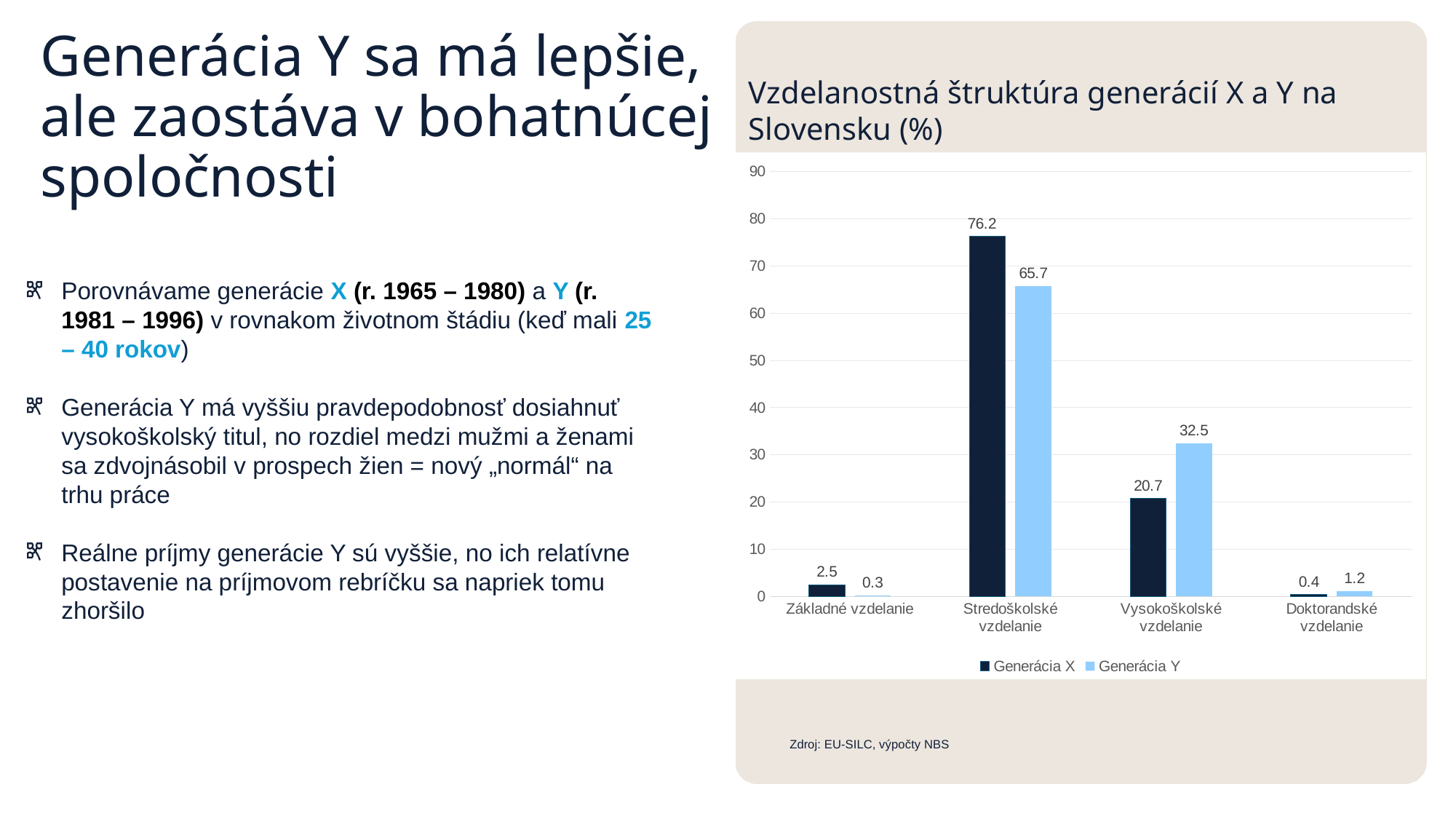
How many categories are shown on the x axis? 4 Which category has the lowest value for Generácia X? Doktorandské vzdelanie How many series does the legend list? 2 What is the value for Generácia X in the Stredoškolské vzdelanie category? 76.2 Which is larger in the Doktorandské vzdelanie category: Generácia X or Generácia Y? Generácia Y What kind of chart is shown on the slide? Bar chart What is the value for Generácia Y in the Vysokoškolské vzdelanie category? 32.5 What is the difference between Generácia Y and Generácia X in the Vysokoškolské vzdelanie category? 11.8 Is the value for Generácia X in the Vysokoškolské vzdelanie category greater or less than 30? less Which category has the highest value for Generácia Y? Stredoškolské vzdelanie What is the value for Generácia Y in the Základné vzdelanie category? 0.3 What is the difference between Generácia X and Generácia Y in the Stredoškolské vzdelanie category? 10.5